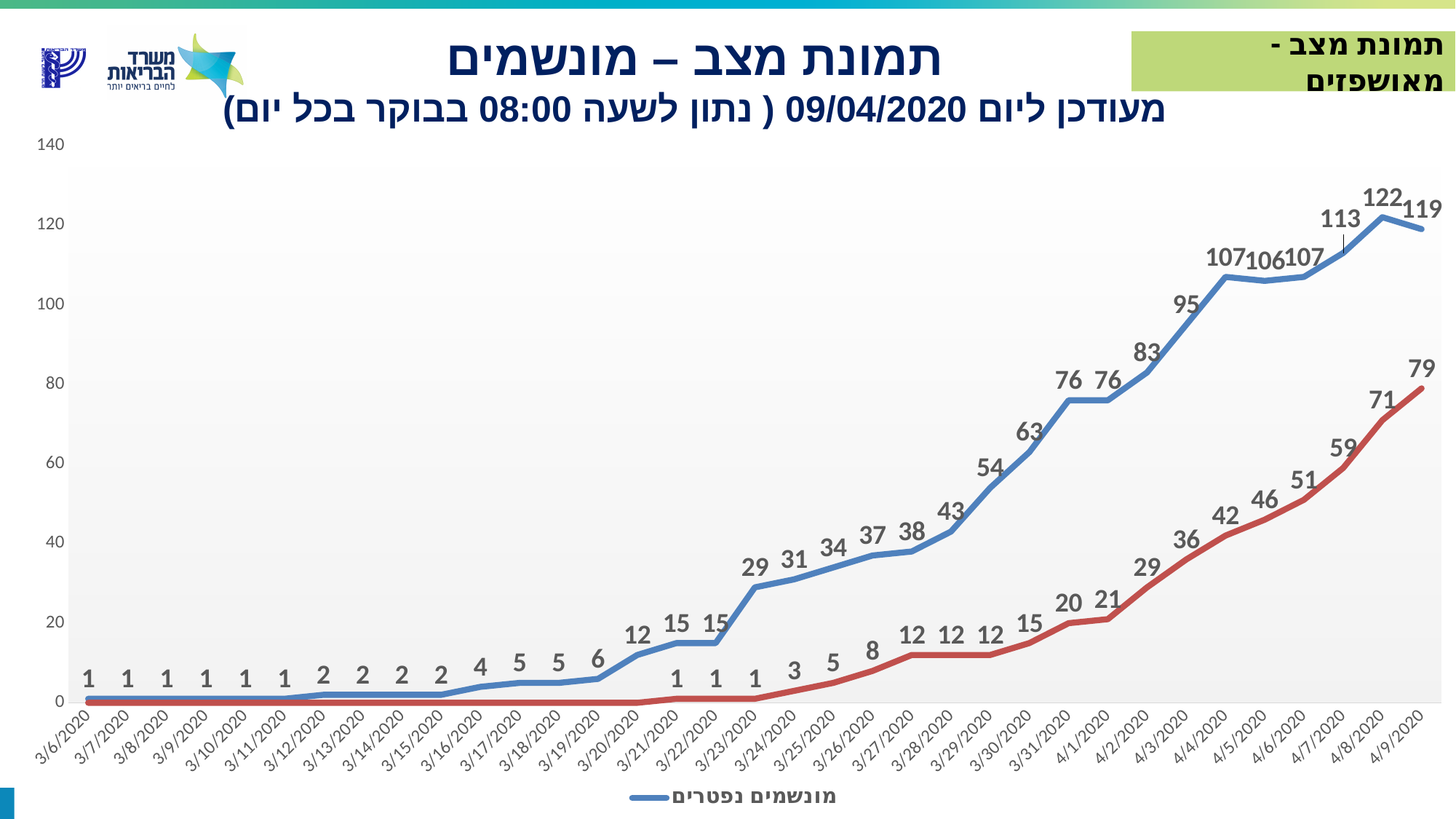
On which date does the blue line reach its highest value? 4/8/2020 What is the difference between the blue line and the red line on 4/9/2020? 40 How many dates are shown on the x axis? 35 What kind of chart is shown on the slide? line chart Is the value of the red line on 4/9/2020 greater or less than 60? greater What is the value of the red line on 3/31/2020? 20 By how much does the blue line drop from 4/8/2020 to 4/9/2020? 3 What is the value of the blue line on 3/23/2020? 29 What is the value of the blue line on 4/8/2020? 122 What is the value of the red line on 4/9/2020? 79 Does the red line generally rise or fall from 3/21/2020 to 4/9/2020? rise On 4/4/2020, which line has the larger value, the blue line or the red line? the blue line